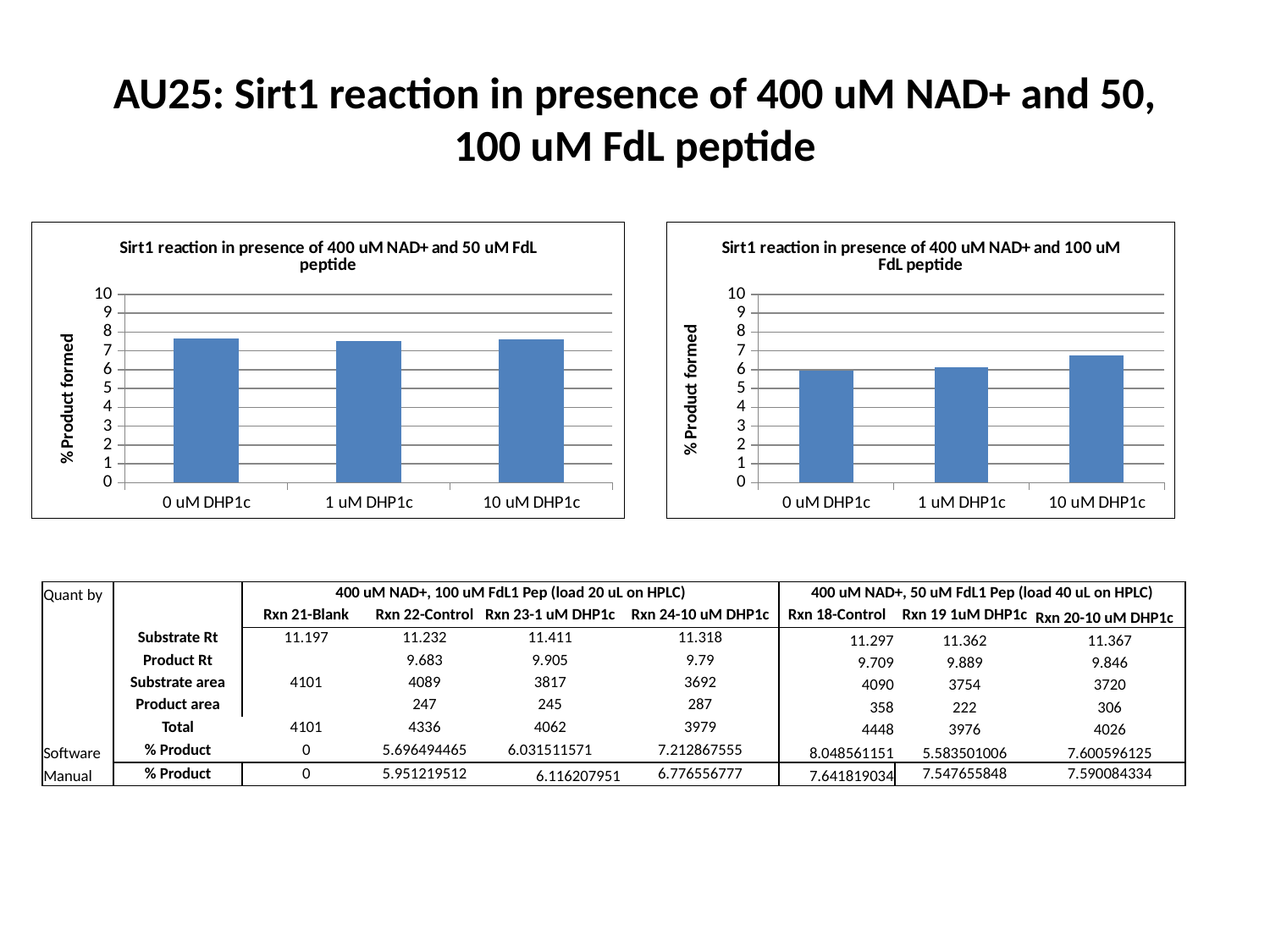
How many categories are shown on the x axis of the right chart (100 uM FdL peptide)? 3 How many bar charts are on the slide? 2 In the left chart (50 uM FdL peptide), is the value for 10 uM DHP1c greater or less than 8? less In the right chart (100 uM FdL peptide), do the values rise or fall from 0 uM DHP1c to 10 uM DHP1c? rise In the left chart (50 uM FdL peptide), is the value for 0 uM DHP1c greater or less than 7? greater In the right chart (100 uM FdL peptide), which is larger: the value for 0 uM DHP1c or 10 uM DHP1c? 10 uM DHP1c In the right chart (100 uM FdL peptide), which category has the highest % product formed? 10 uM DHP1c What kind of chart is the left chart titled 'Sirt1 reaction in presence of 400 uM NAD+ and 50 uM FdL peptide'? bar chart In the right chart (100 uM FdL peptide), is the value for 10 uM DHP1c greater or less than 6? greater What is the maximum value shown on the y axis of the right chart (100 uM FdL peptide)? 10 What is the y-axis label of the left chart (50 uM FdL peptide)? % Product formed